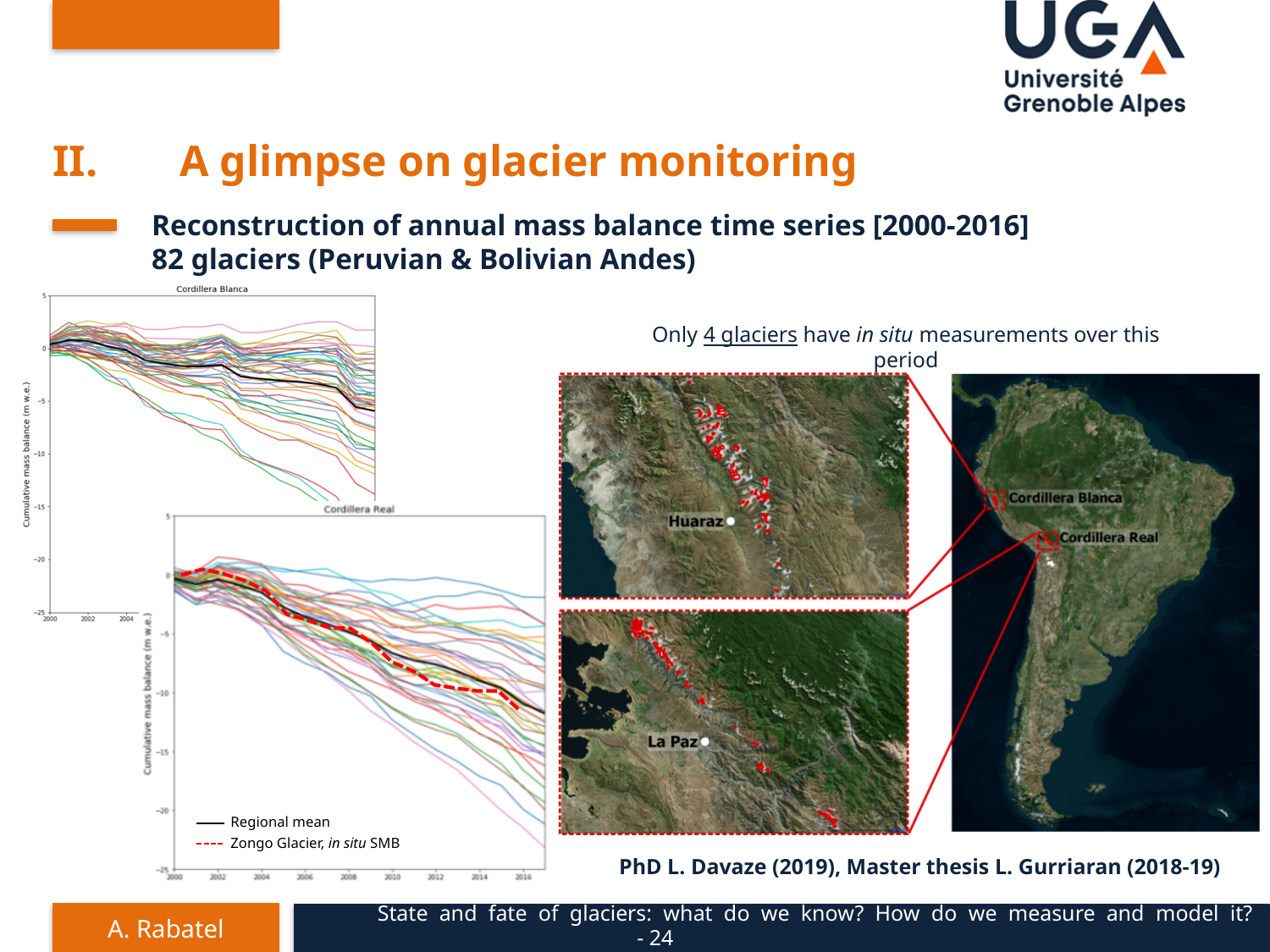
In the "Cordillera Real" chart, is the regional mean value in 2002 greater or less than -5? greater What kind of chart is the "Cordillera Real" chart? line chart How many line charts are shown on the slide? 2 What kind of chart is the "Cordillera Blanca" chart on the left of the slide? line chart In the "Cordillera Real" chart, is the regional mean value in 2016 greater or less than -5? less In the "Cordillera Real" chart, does the regional mean (black line) rise or fall from 2000 to 2016? fall In the "Cordillera Blanca" chart, does the regional mean (black line) rise or fall along the x axis? fall In the "Cordillera Real" chart, what does the red dashed line represent according to the legend? Zongo Glacier, in situ SMB What is the y-axis label of the "Cordillera Real" chart? Cumulative mass balance (m w.e.) How many entries does the legend of the "Cordillera Real" chart list? 2